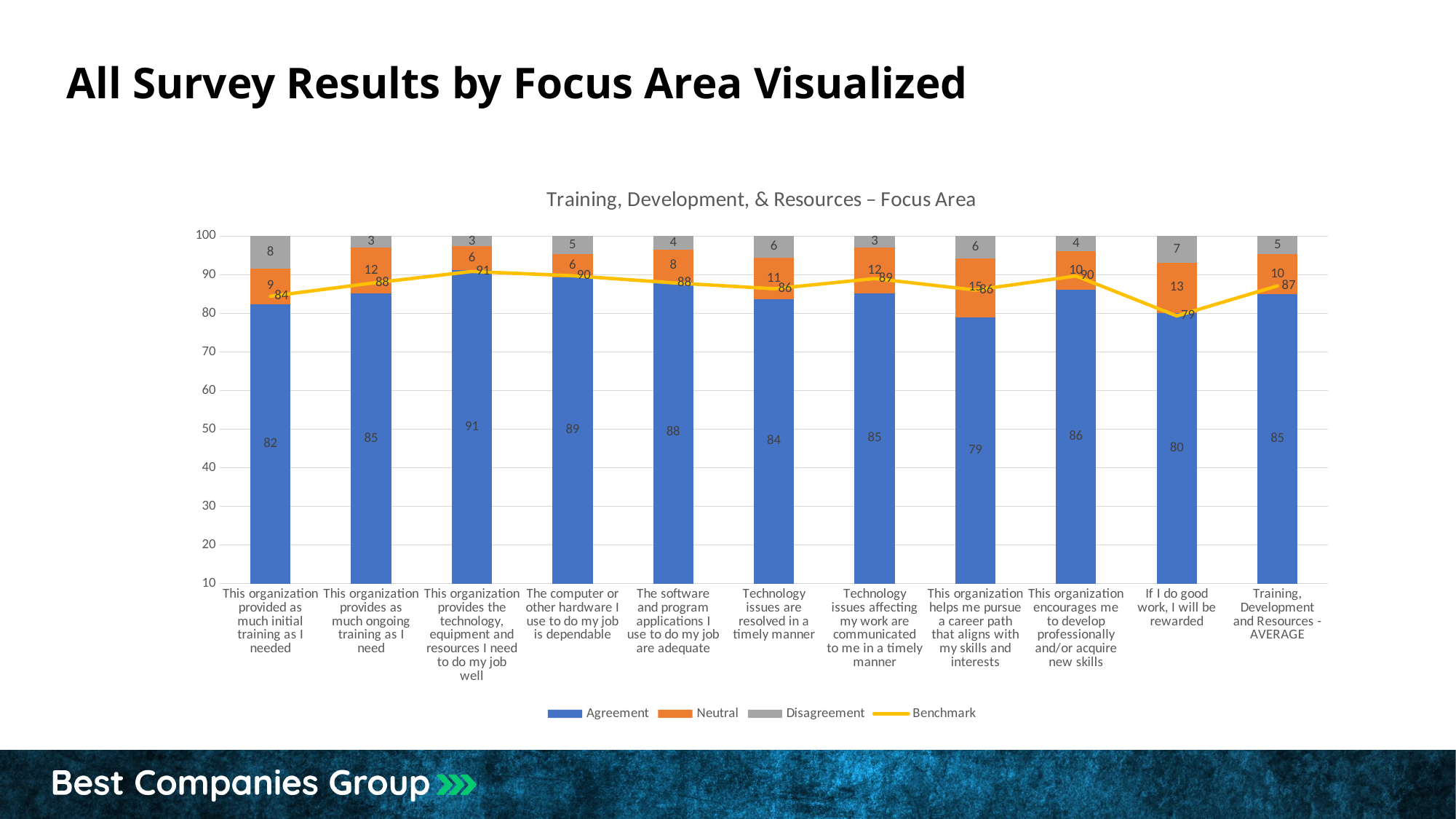
What is the Disagreement value for "This organization provided as much initial training as I needed"? 8 How many series does the legend list? 4 What is the Agreement value for "If I do good work, I will be rewarded"? 80 Which is larger for "If I do good work, I will be rewarded": the Agreement value or the Benchmark value? Agreement What kind of chart is shown on the slide? Stacked bar chart with a line How many categories are shown on the x axis? 11 What is the total of the stacked bar for "Training, Development and Resources - AVERAGE"? 100 What is the Benchmark value for "This organization provides as much ongoing training as I need"? 88 What is the difference between the Benchmark and the Agreement value for "Technology issues affecting my work are communicated to me in a timely manner"? 4 Which category has the lowest Agreement value? This organization helps me pursue a career path that aligns with my skills and interests Which category has the highest Agreement value? This organization provides the technology, equipment and resources I need to do my job well What is the Neutral value for "This organization helps me pursue a career path that aligns with my skills and interests"? 15